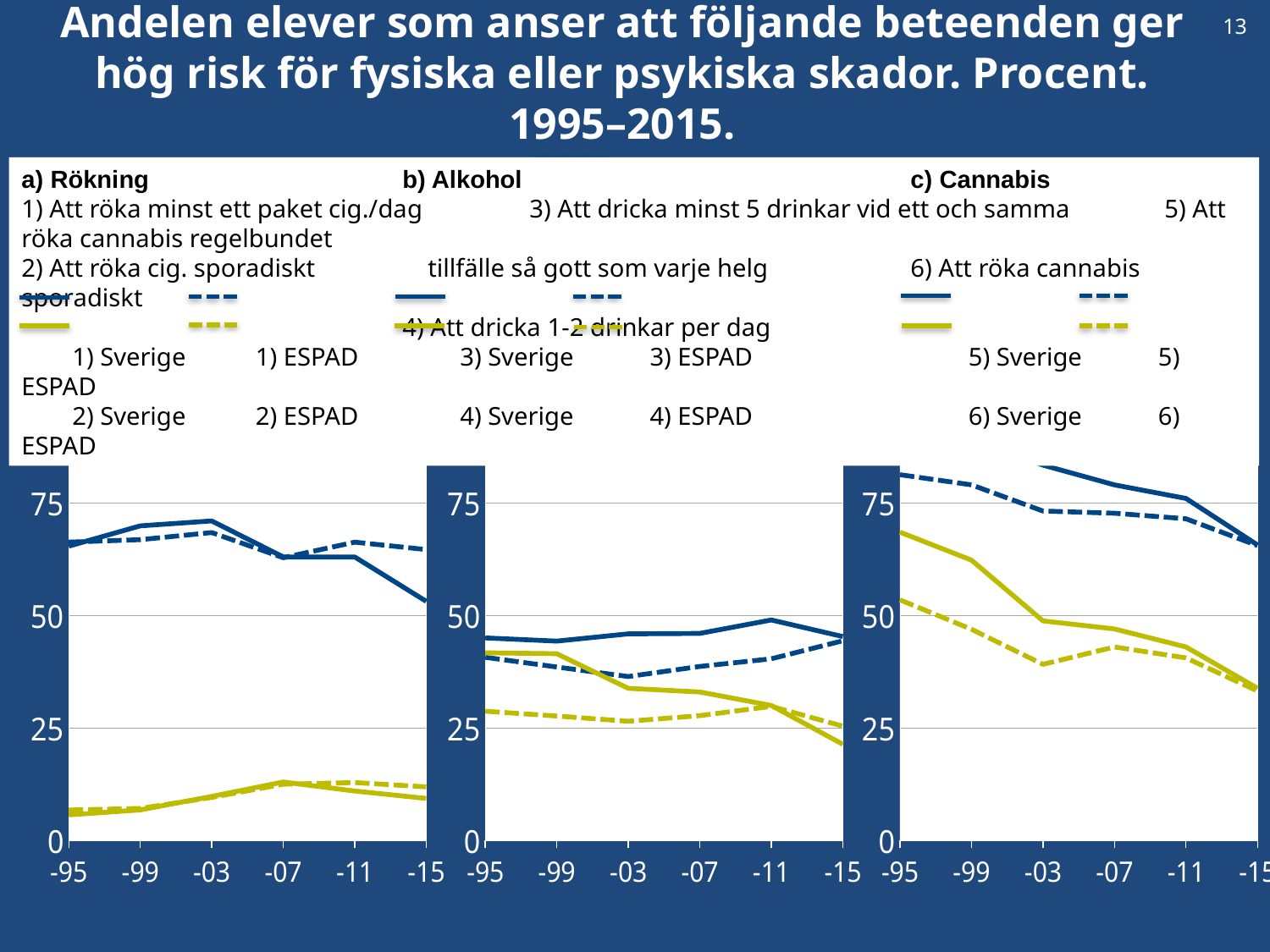
How many series does the legend list for the b) Alkohol chart? 4 How many points are shown along the x axis of the c) Cannabis chart? 6 In the a) Rökning chart, which is larger in -95: 1) Sverige or 2) Sverige? 1) Sverige In the b) Alkohol chart, is the value for 4) Sverige in -15 greater or less than 25? less What kind of chart is used for a) Rökning? Line chart What is the label of the third chart on the slide? c) Cannabis In the c) Cannabis chart, is the value for 5) Sverige in -95 greater or less than 75? greater In the c) Cannabis chart, is the value for 6) Sverige in -15 greater or less than 50? less In the c) Cannabis chart, does the 6) Sverige line rise or fall from -95 to -15? fall In the c) Cannabis chart, which is larger in -15: 5) Sverige or 6) Sverige? 5) Sverige